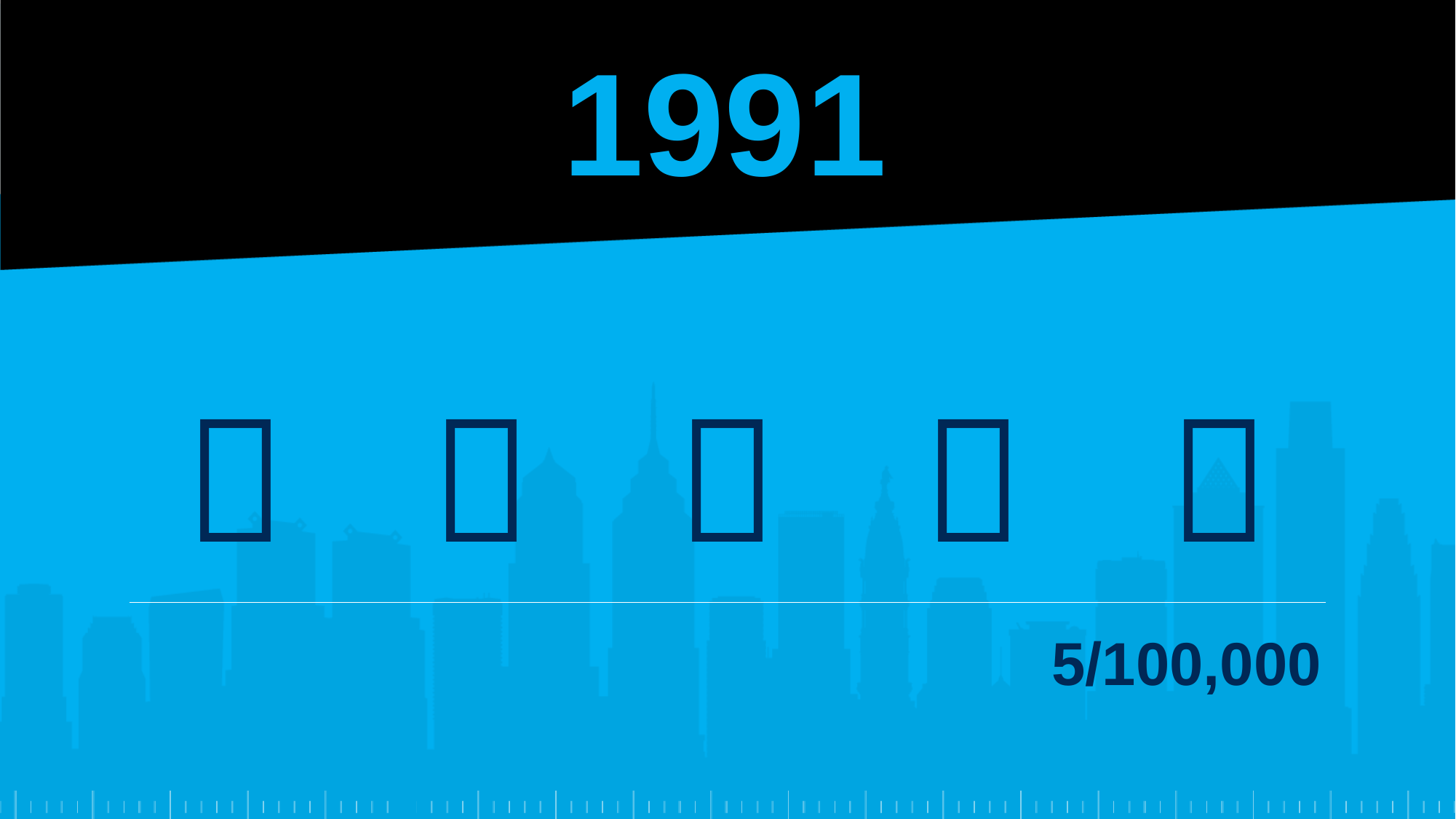
What year is shown at the top of the slide? 1991 How many icon shapes are shown in the row above the line? 5 Is the number shown in the rate (5 per 100,000) greater or less than 10? less What rate is printed below the row of icons? 5/100,000